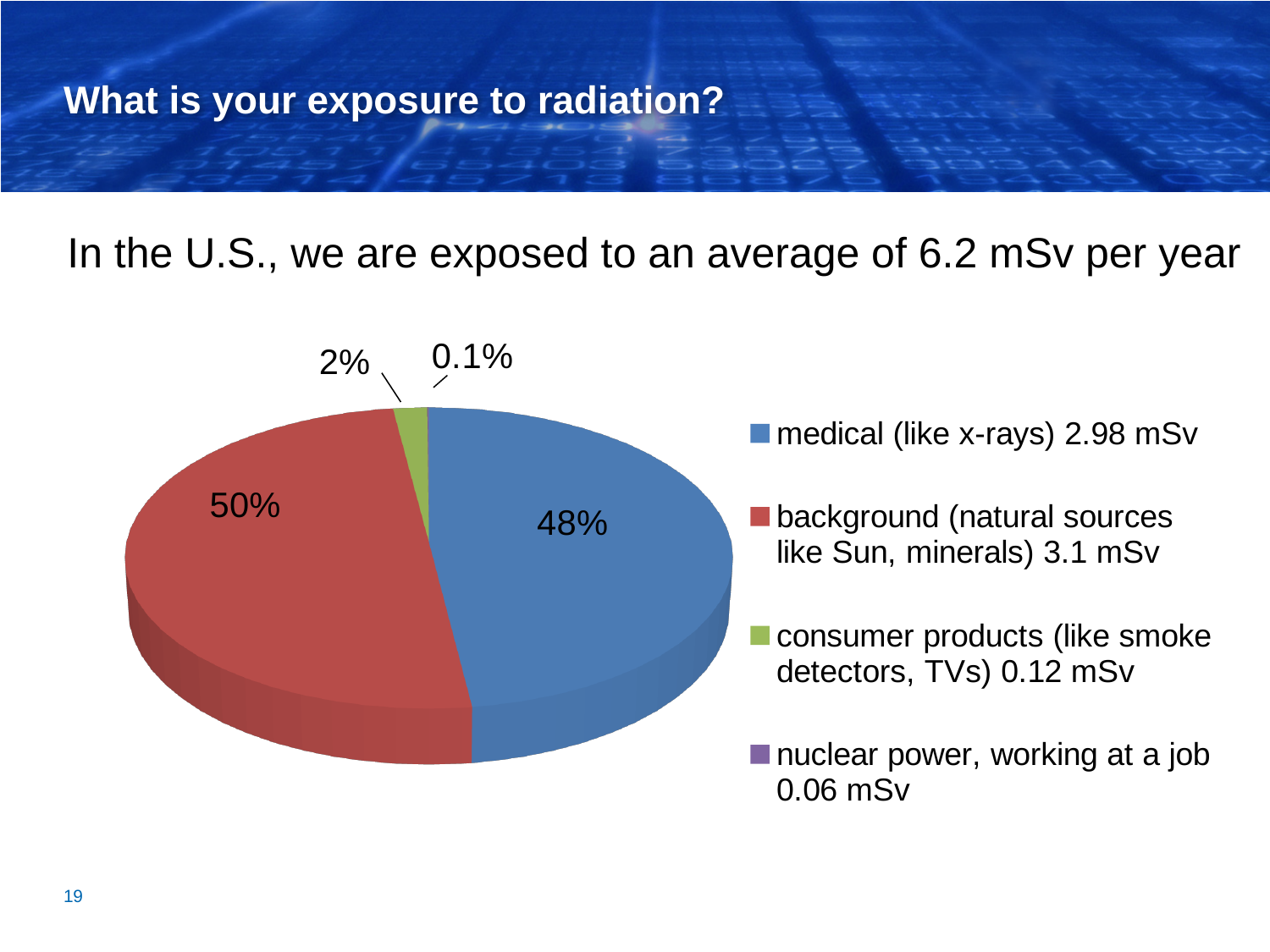
What is the difference in percentage points between the background slice and the medical slice? 2 What percentage of the pie is the nuclear power, working at a job slice? 0.1% What colour is the medical (like x-rays) slice? blue What percentage of the pie is the background (natural sources like Sun, minerals) slice? 50% What percentage of the pie is the medical (like x-rays) slice? 48% What mSv value does the legend give for consumer products (like smoke detectors, TVs)? 0.12 mSv What kind of chart is shown on the slide? pie chart How many categories does the legend list? 4 Which category has the largest share of the pie? background (natural sources like Sun, minerals) Which is larger, the medical slice or the consumer products slice? medical (like x-rays) Which category has the smallest share of the pie? nuclear power, working at a job